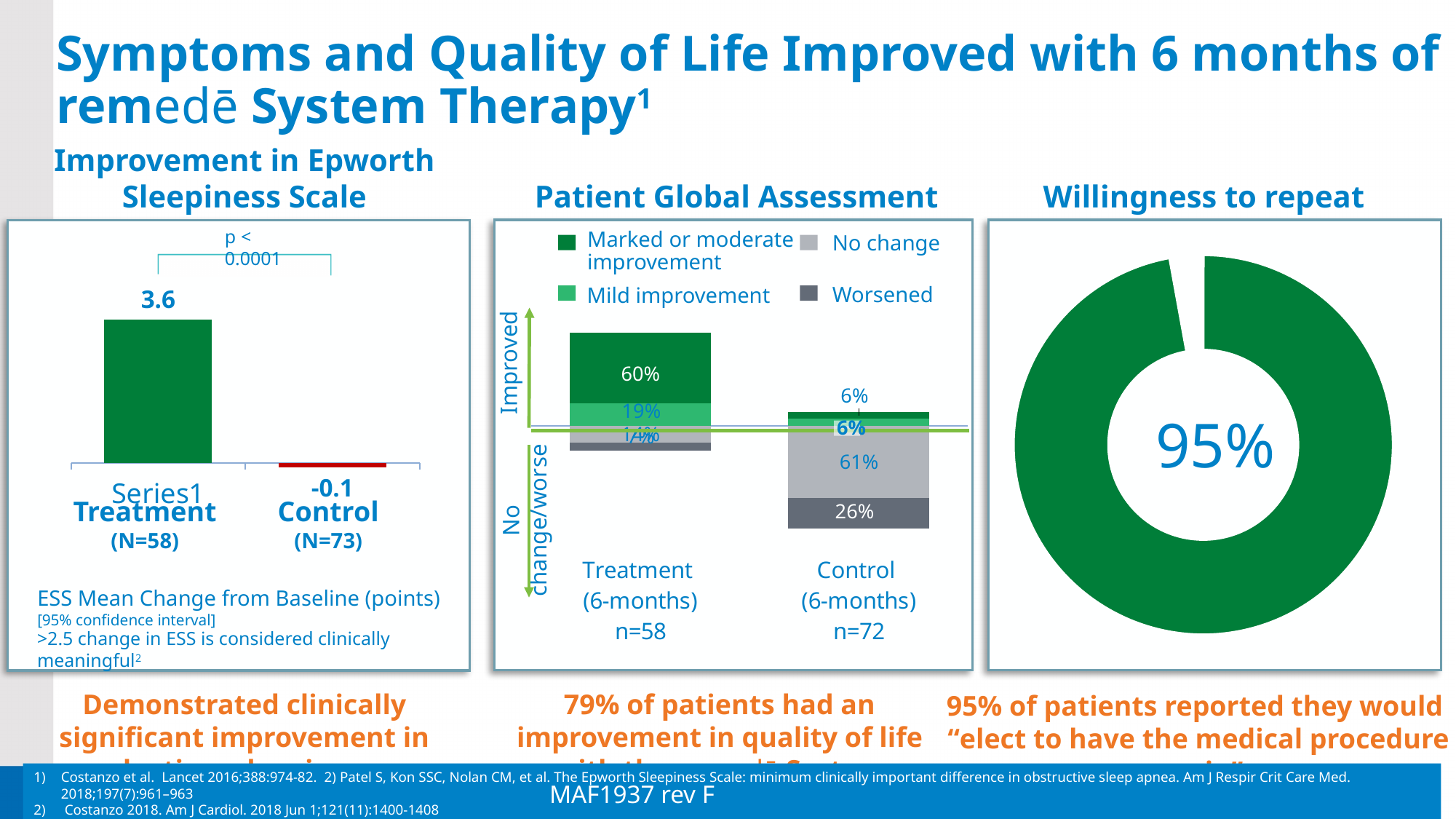
In the Patient Global Assessment chart, what percentage of the Control group worsened? 26% In the Patient Global Assessment chart, which group has the larger share of marked or moderate improvement, Treatment or Control? Treatment In the Improvement in Epworth Sleepiness Scale chart, what is the ESS mean change from baseline for the Control group? -0.1 In the Patient Global Assessment chart, what percentage of the Treatment group had marked or moderate improvement? 60% In the Improvement in Epworth Sleepiness Scale chart, what is the ESS mean change from baseline for the Treatment group? 3.6 What kind of chart is the Improvement in Epworth Sleepiness Scale chart? Bar chart In the Patient Global Assessment chart, what is the sample size (n) for the Control group? n=72 In the Willingness to repeat chart, what percentage is shown in the centre of the donut? 95% In the Patient Global Assessment chart, what percentage of the Control group had no change? 61% In the Improvement in Epworth Sleepiness Scale chart, what is the difference between the Treatment and Control values? 3.7 In the Patient Global Assessment chart, how many categories does the legend list? 4 In the Improvement in Epworth Sleepiness Scale chart, which group has the higher value, Treatment or Control? Treatment